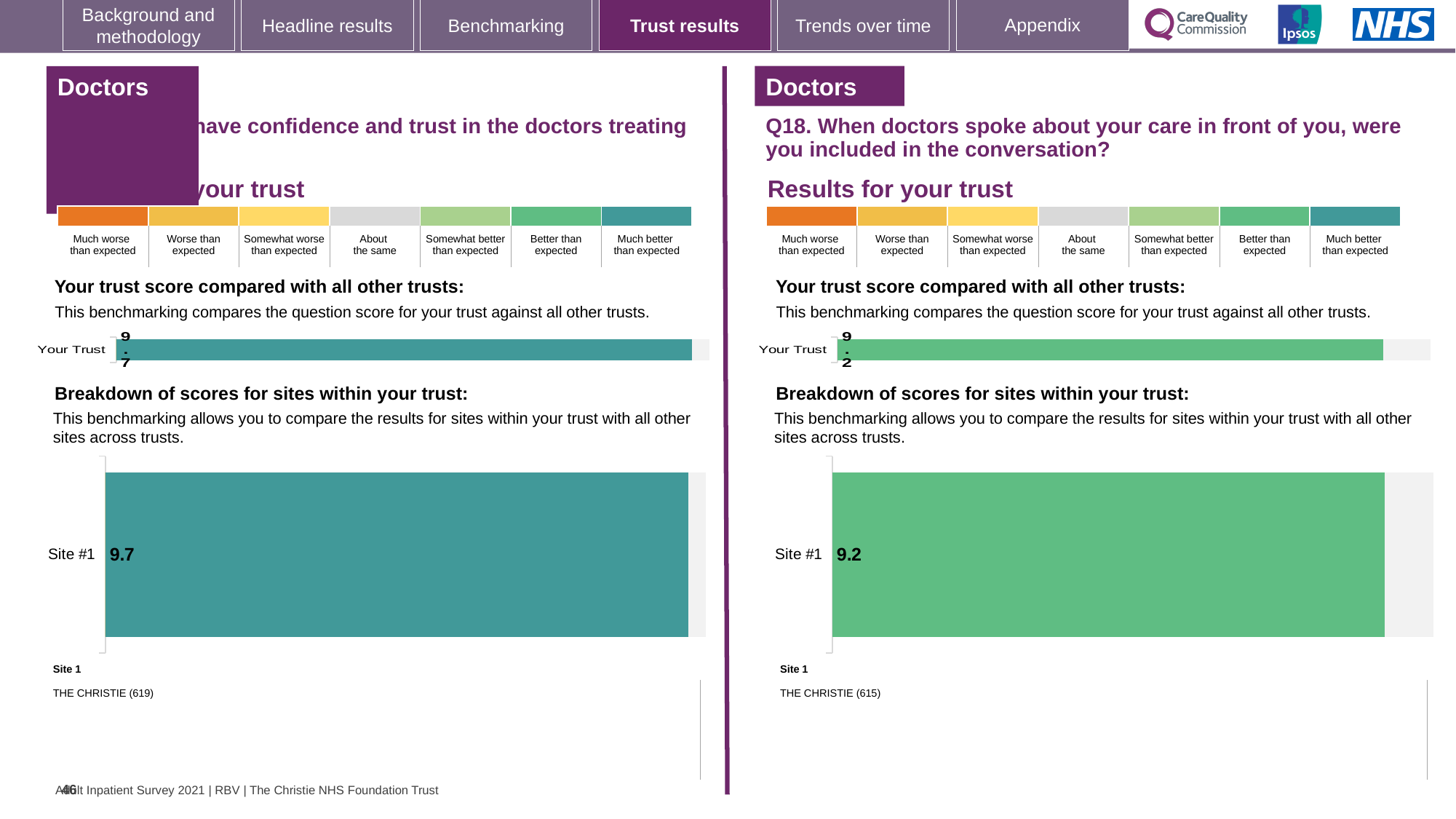
Is the Site #1 score on the right-hand (Q18) chart greater or less than the Site #1 score on the left-hand chart? less How many sites are shown in the breakdown of scores chart on the right-hand side (Q18) of the slide? 1 How many sites are shown in the breakdown of scores chart on the left-hand side of the slide? 1 On the left-hand side of the slide, what is the value shown for Your Trust in the trust score comparison chart? 9.7 On the right-hand side of the slide (Q18), what is the value shown for Your Trust in the trust score comparison chart? 9.2 Which site name is listed under Site 1 on the left-hand side of the slide? THE CHRISTIE (619) What type of chart is used to show the Site #1 score on the right-hand side of the slide? Bar chart On the left-hand side of the slide, what is the score shown for Site #1 in the breakdown of scores for sites within your trust? 9.7 Which is larger: the Site #1 score on the left-hand chart or the Site #1 score on the right-hand (Q18) chart? The left-hand chart (9.7) On the right-hand side of the slide (Q18), what is the score shown for Site #1 in the breakdown of scores for sites within your trust? 9.2 Which site name is listed under Site 1 on the right-hand side (Q18) of the slide? THE CHRISTIE (615) What is the difference between the Site #1 score on the left-hand chart (9.7) and the Site #1 score on the right-hand Q18 chart (9.2)? 0.5